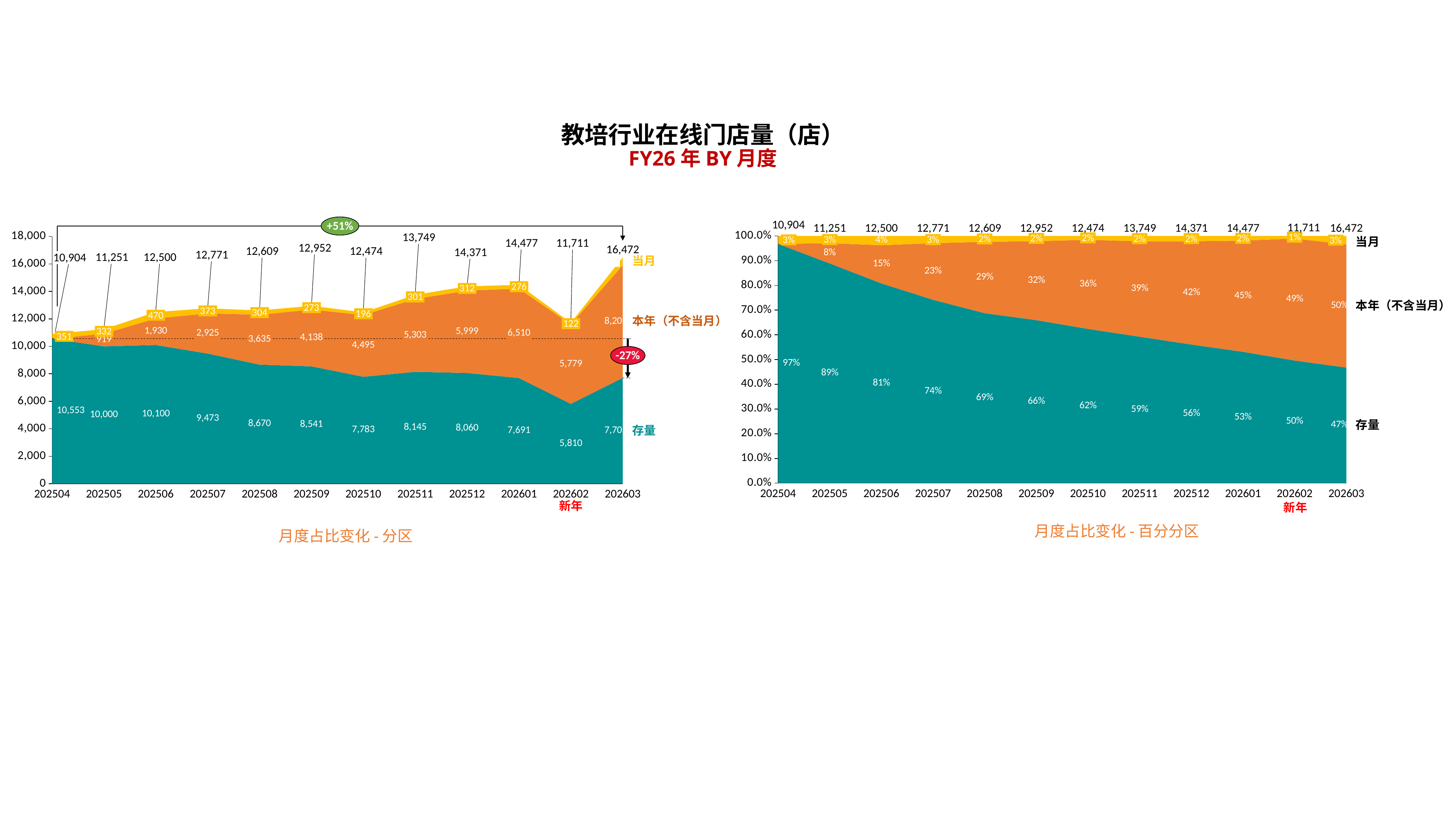
In the left chart (月度占比变化 - 分区), which month has the lowest 存量 value? 202602 In the left chart (月度占比变化 - 分区), what is the difference between the total for 202603 and the total for 202602? 4,761 How many months are shown on the x axis of the left chart (月度占比变化 - 分区)? 12 In the left chart (月度占比变化 - 分区), is the 当月 value larger for 202505 or 202507? 202507 In the left chart (月度占比变化 - 分区), what is the 存量 value for 202602? 5,810 In the left chart (月度占比变化 - 分区), what is the total value labeled for 202603? 16,472 In the right chart (月度占比变化 - 百分分区), what is the 本年（不含当月） share for 202603? 50% In the left chart (月度占比变化 - 分区), is the 存量 value for 202603 greater or less than 8,000? less In the left chart (月度占比变化 - 分区), what is the 当月 value for 202506? 470 In the left chart (月度占比变化 - 分区), which month has the highest total value? 202603 In the right chart (月度占比变化 - 百分分区), does the 存量 share rise or fall from 202504 to 202603? fall In the right chart (月度占比变化 - 百分分区), what is the 存量 share for 202504? 97%